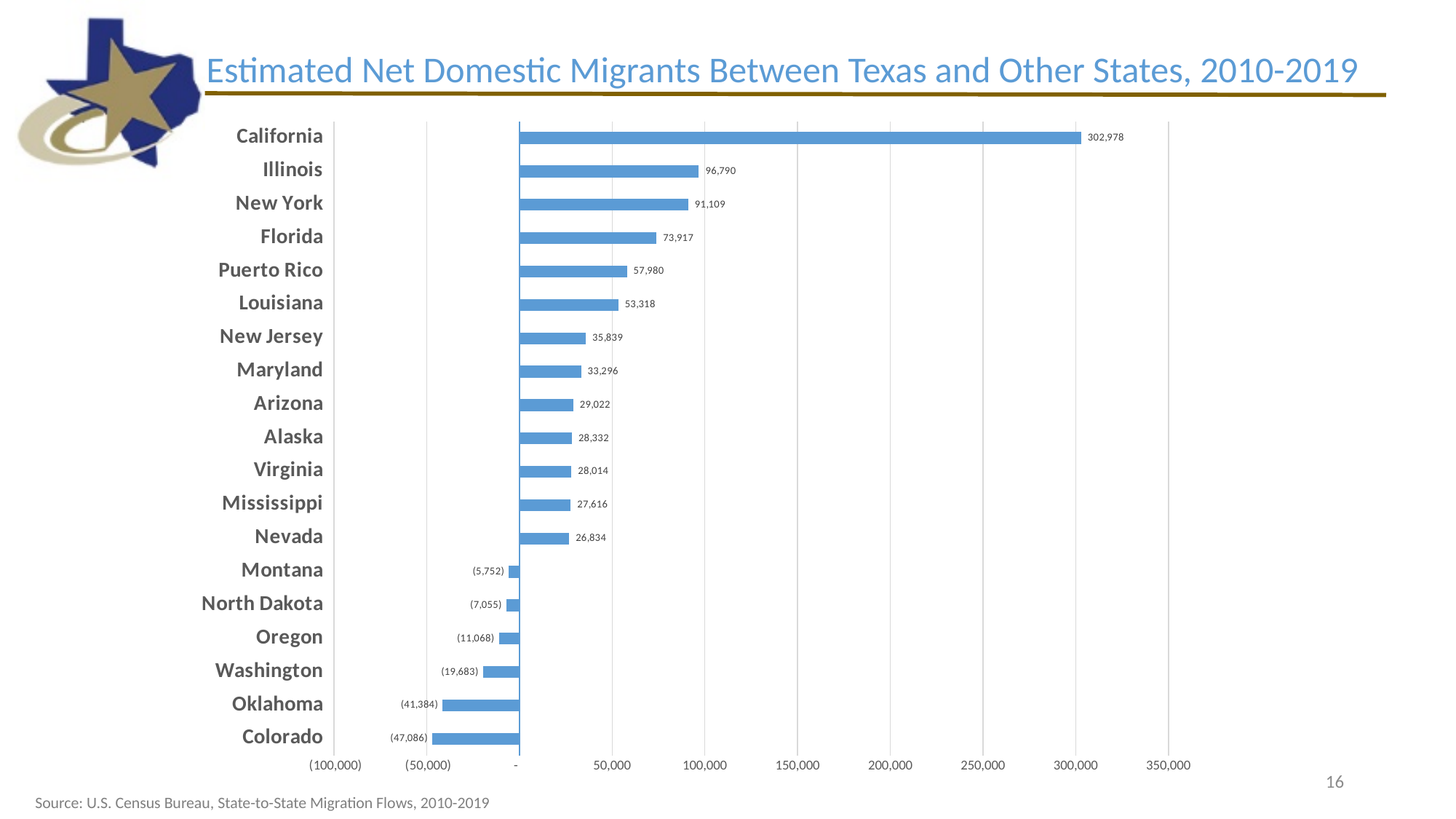
What is the value shown for Colorado? (47,086) How many states or territories are listed on the chart? 19 What is the difference between the values for Illinois and New York? 5,681 What is the estimated net domestic migration value for California? 302,978 What is the value shown for Washington? (19,683) What is the source cited for the chart data? U.S. Census Bureau, State-to-State Migration Flows, 2010-2019 Which state has the lowest (most negative) value on the chart? Colorado What kind of chart is shown on the slide? Bar chart Which state has the highest net domestic migration value on the chart? California What is the value shown for Puerto Rico? 57,980 Which has a larger value, Florida or Louisiana? Florida Is the value for New Jersey greater or less than 50,000? less